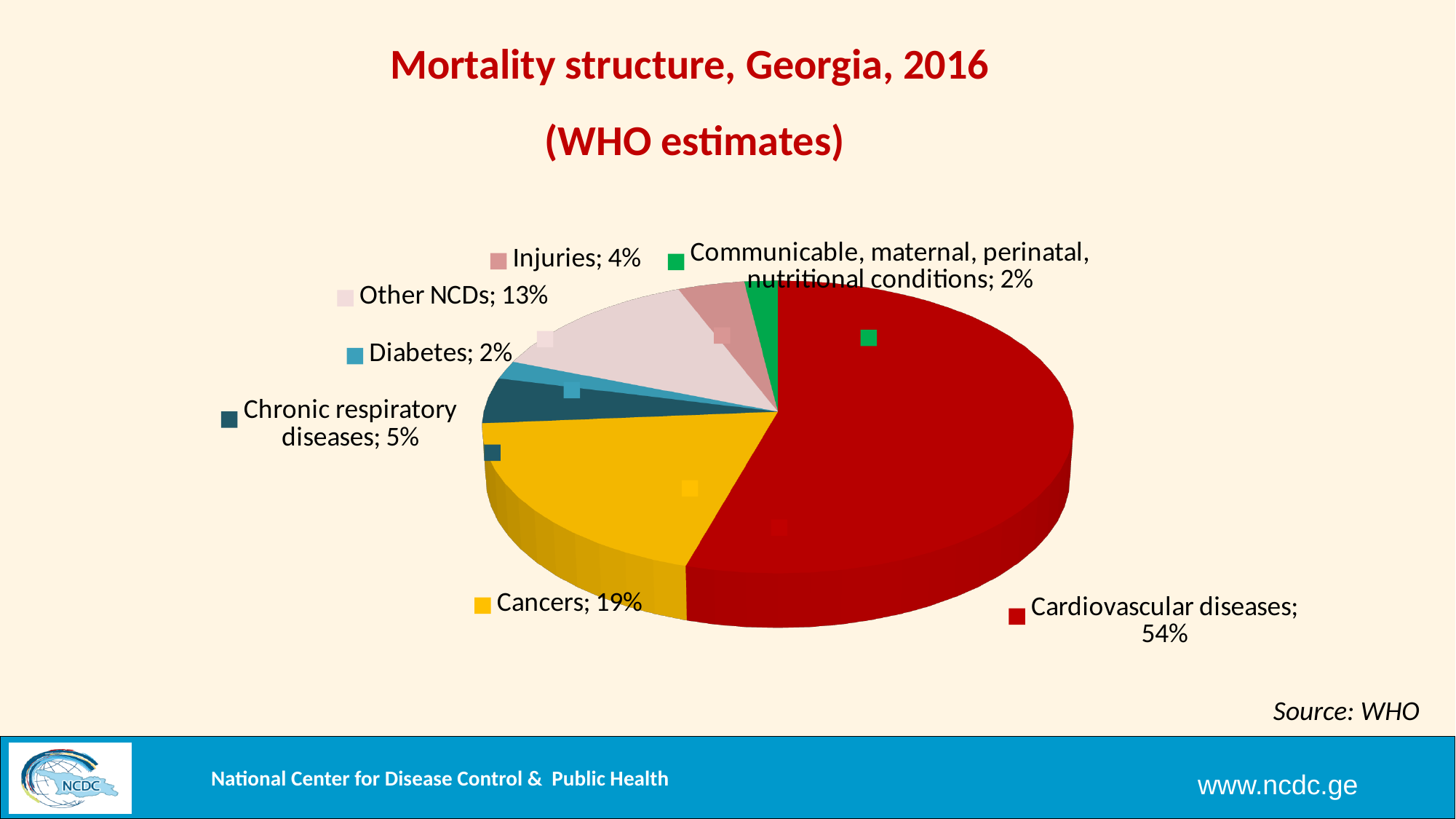
What share of mortality is attributed to cardiovascular diseases? 54% How many categories are shown in the pie chart? 7 What colour is the slice for cancers? Yellow What share is shown for Other NCDs? 13% What percentage is shown for chronic respiratory diseases? 5% Which category has the largest slice of the pie? Cardiovascular diseases Which is larger, the share for Other NCDs or the share for injuries? Other NCDs What is the difference in percentage points between cardiovascular diseases and cancers? 35 What type of chart is shown on the slide? Pie chart What percentage of the pie is for cancers? 19% What is the title of the chart? Mortality structure, Georgia, 2016 (WHO estimates) What share is shown for injuries? 4%